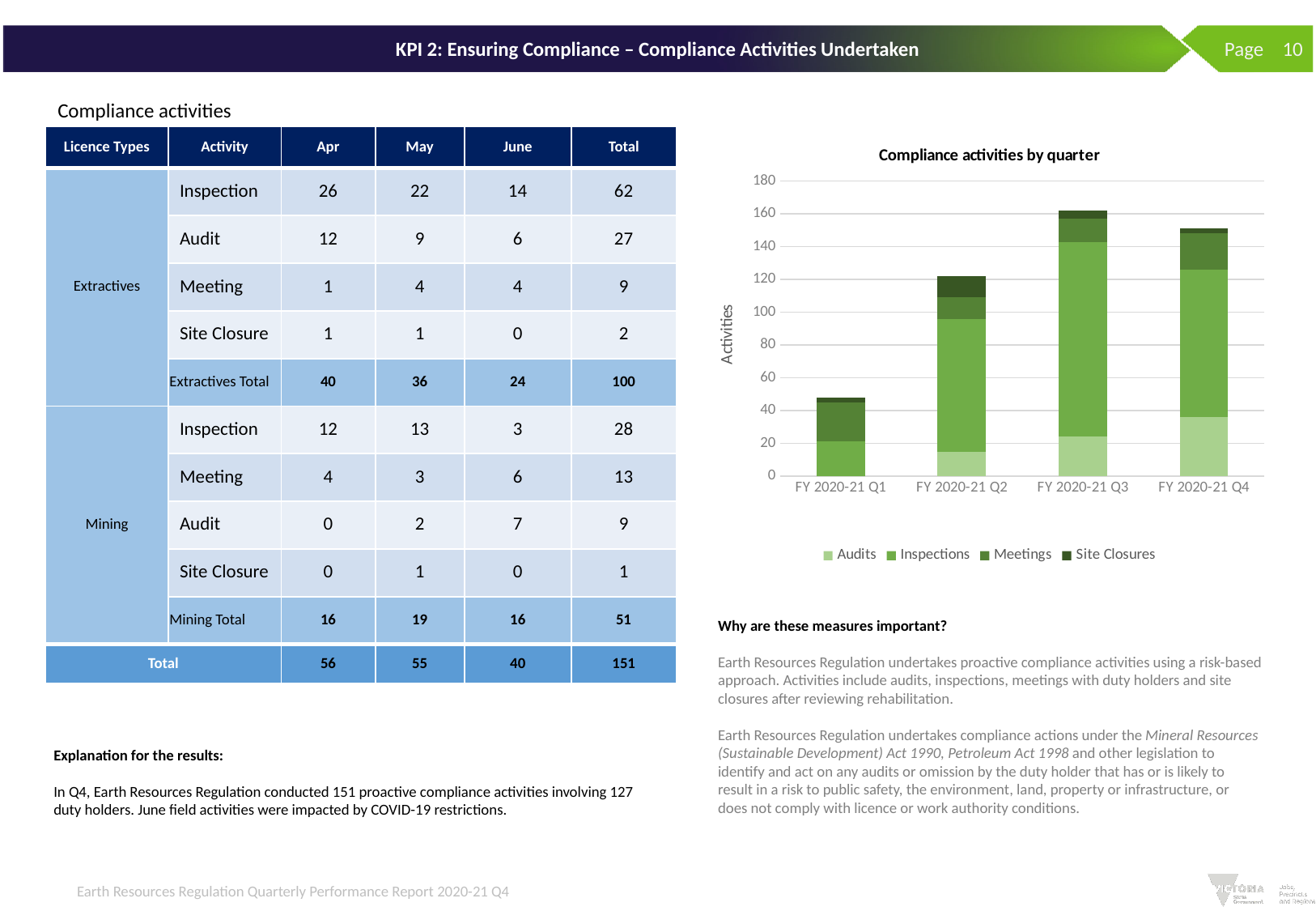
Is the total bar height for FY 2020-21 Q1 greater or less than 60? less Which quarter has the shortest stacked bar in the chart? FY 2020-21 Q1 Is the total bar height for FY 2020-21 Q3 greater or less than 140? greater How many quarters are shown on the x axis of the chart? 4 Which quarter has the tallest stacked bar in the chart? FY 2020-21 Q3 How many series does the chart legend list? 4 Is the total bar height for FY 2020-21 Q2 greater or less than 100? greater What kind of chart is shown on the slide? Stacked bar chart What is the label on the y axis of the chart? Activities What is the title of the chart on the slide? Compliance activities by quarter Do the total bar heights rise or fall from FY 2020-21 Q1 to FY 2020-21 Q3? rise Which has the taller stacked bar, FY 2020-21 Q2 or FY 2020-21 Q4? FY 2020-21 Q4